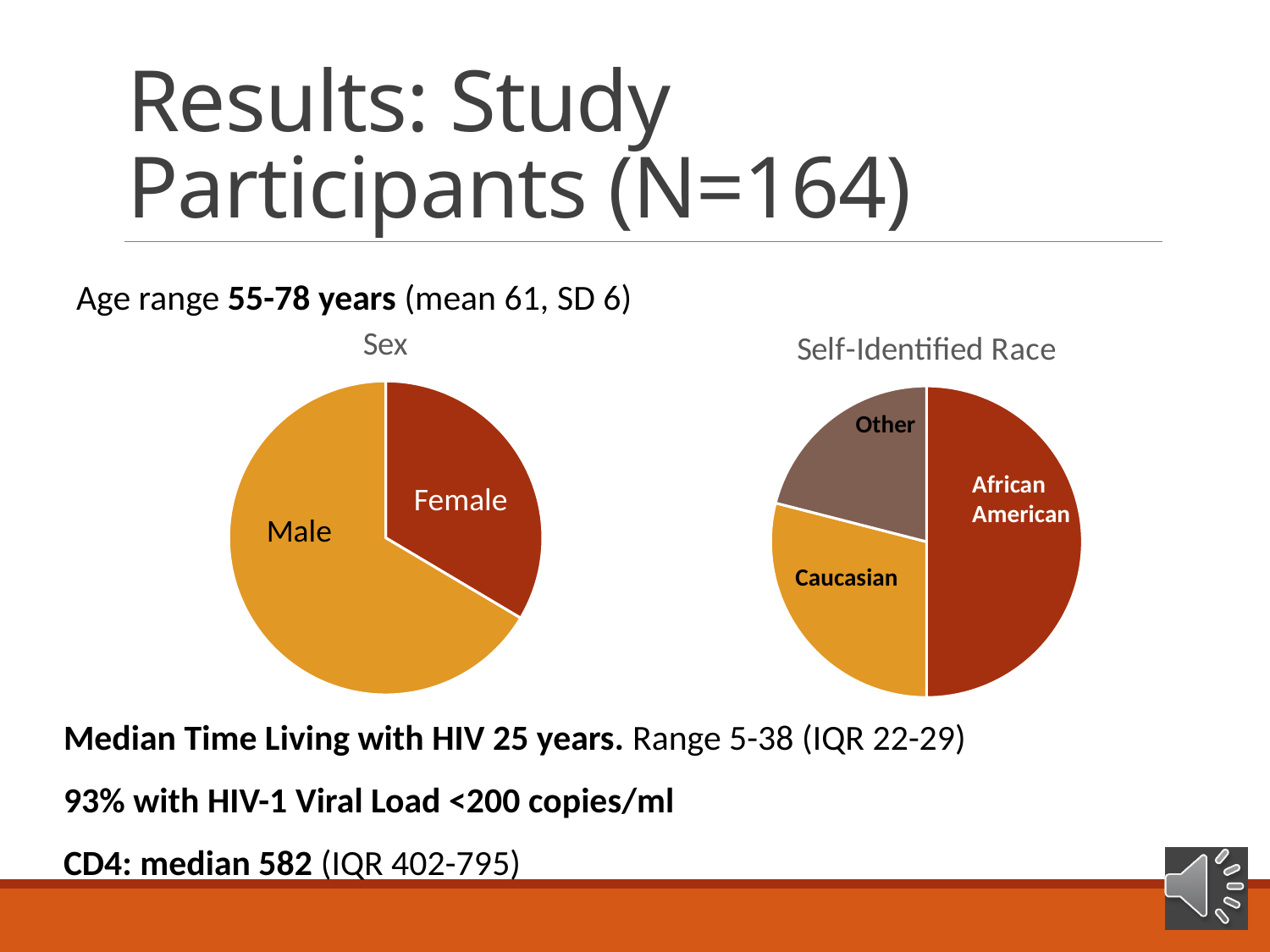
In the 'Sex' chart, which slice is larger: Male or Female? Male In the 'Sex' chart, which category has the largest slice? Male What kind of chart is the 'Sex' chart? pie chart In the 'Self-Identified Race' chart, which category has the largest slice? African American In the 'Sex' chart, which category has the smallest slice? Female In the 'Self-Identified Race' chart, which category has the smallest slice? Other In the 'Sex' chart, what colour is the Female slice? dark red What is the title of the pie chart on the right side of the slide? Self-Identified Race How many slices does the 'Sex' pie chart have? 2 How many slices does the 'Self-Identified Race' pie chart have? 3 What kind of chart is the 'Self-Identified Race' chart? pie chart In the 'Self-Identified Race' chart, which slice is larger: Caucasian or Other? Caucasian